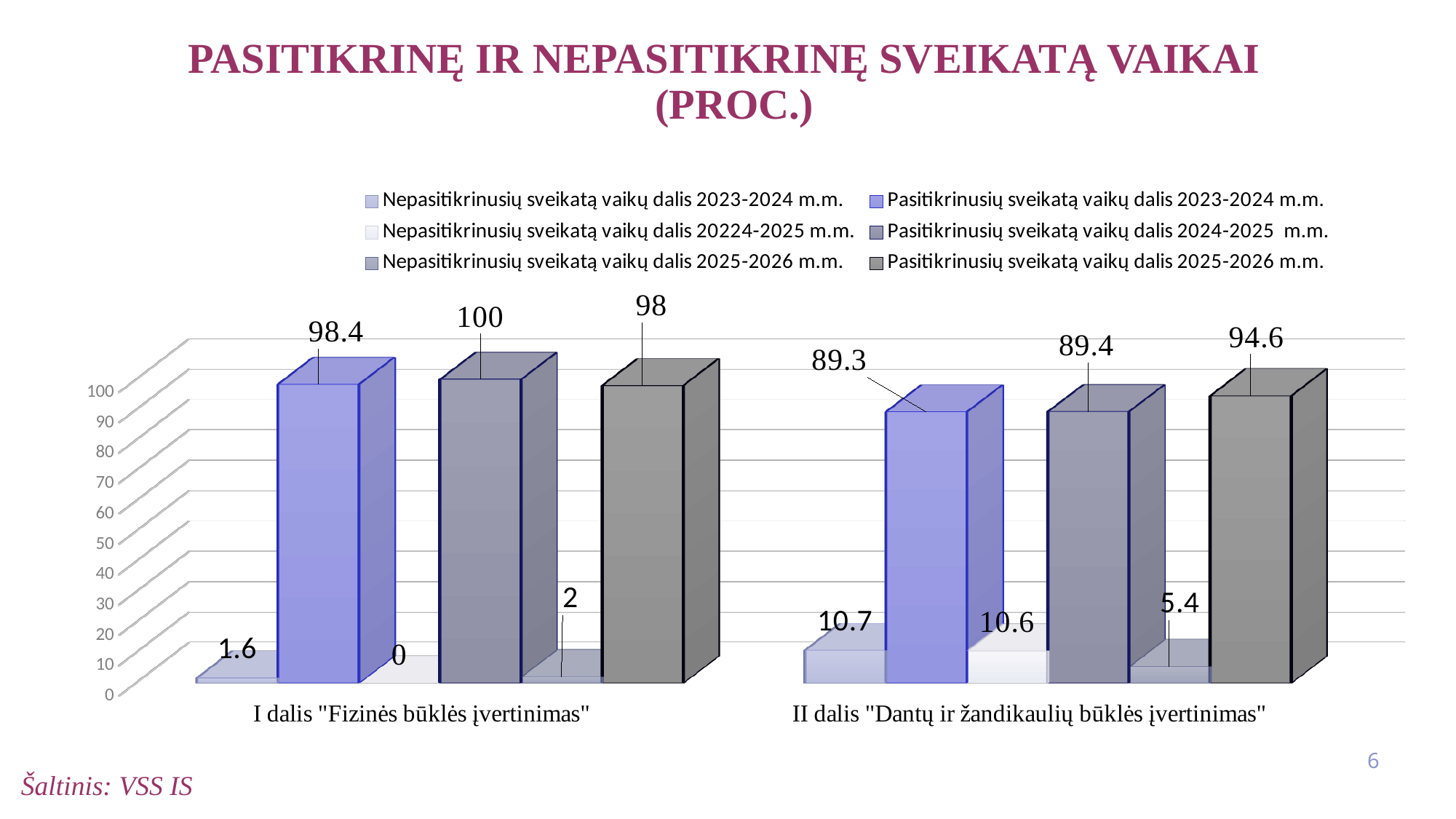
What is the value of "Pasitikrinusių sveikatą vaikų dalis 2025-2026 m.m." for II dalis "Dantų ir žandikaulių būklės įvertinimas"? 94.6 What is the value of "Nepasitikrinusių sveikatą vaikų dalis 2023-2024 m.m." for I dalis "Fizinės būklės įvertinimas"? 1.6 What is the value of "Pasitikrinusių sveikatą vaikų dalis 2023-2024 m.m." for I dalis "Fizinės būklės įvertinimas"? 98.4 What is the difference between the "Pasitikrinusių sveikatą vaikų dalis 2025-2026 m.m." values for I dalis and II dalis? 3.4 How many categories are shown on the x axis? 2 What is the title of the chart on the slide? PASITIKRINĘ IR NEPASITIKRINĘ SVEIKATĄ VAIKAI (PROC.) What type of chart is shown on the slide? bar chart What is the value of "Pasitikrinusių sveikatą vaikų dalis 2024-2025 m.m." for I dalis "Fizinės būklės įvertinimas"? 100 Which series has the highest value for I dalis "Fizinės būklės įvertinimas"? Pasitikrinusių sveikatą vaikų dalis 2024-2025 m.m. What is the value of "Nepasitikrinusių sveikatą vaikų dalis 2025-2026 m.m." for II dalis "Dantų ir žandikaulių būklės įvertinimas"? 5.4 Which is larger for II dalis "Dantų ir žandikaulių būklės įvertinimas": "Nepasitikrinusių sveikatą vaikų dalis 2023-2024 m.m." or "Nepasitikrinusių sveikatą vaikų dalis 2025-2026 m.m."? Nepasitikrinusių sveikatą vaikų dalis 2023-2024 m.m. How many series does the legend list? 6